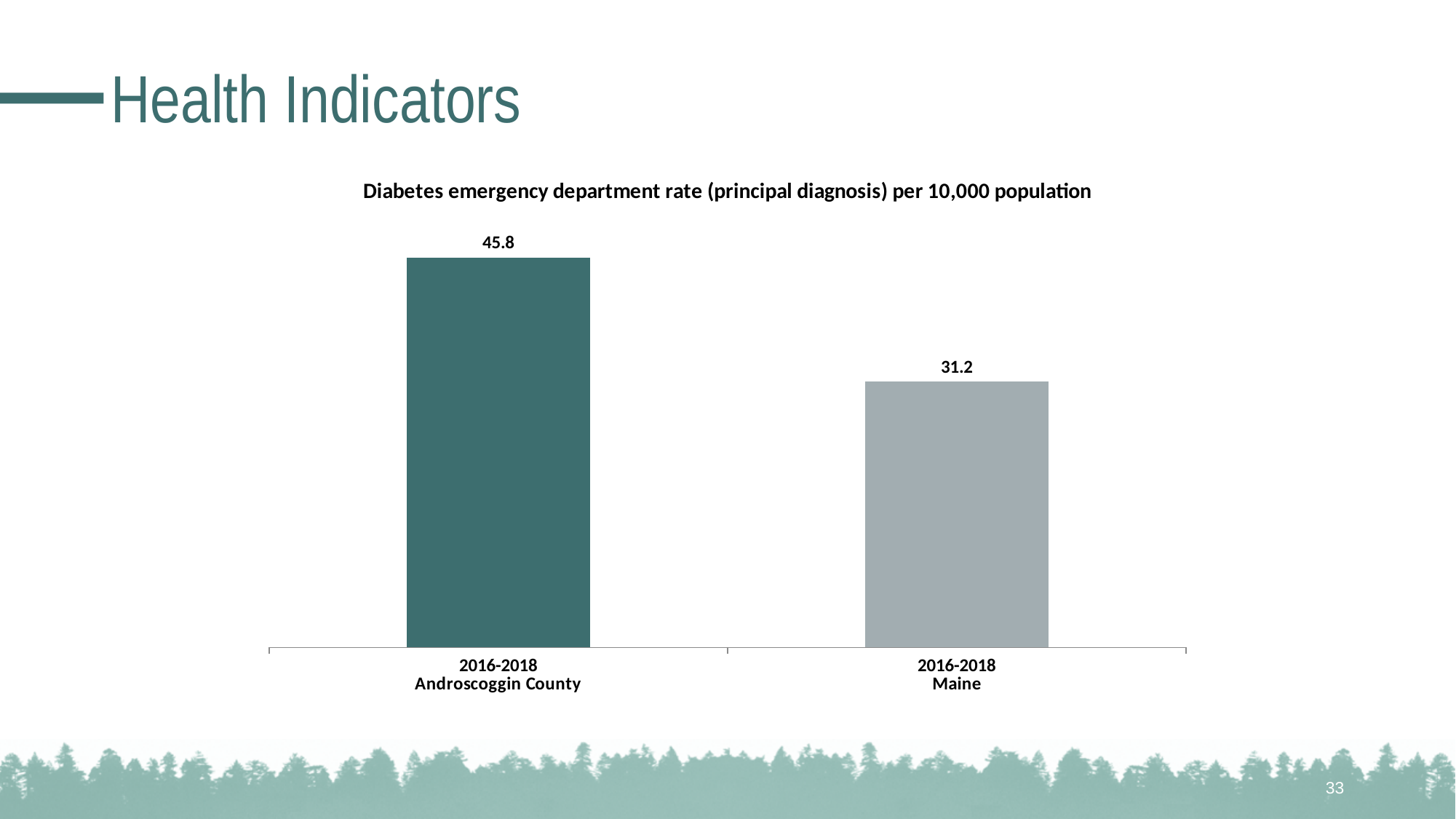
What time period do both bars in the chart cover? 2016-2018 How many bars are shown in the chart? 2 What is the difference between the Androscoggin County rate and the Maine rate? 14.6 What is the title of the chart? Diabetes emergency department rate (principal diagnosis) per 10,000 population What is the diabetes emergency department rate per 10,000 population for Androscoggin County in 2016-2018? 45.8 Which category has the higher diabetes emergency department rate? Androscoggin County What is the diabetes emergency department rate per 10,000 population for Maine in 2016-2018? 31.2 Which category has the lower diabetes emergency department rate? Maine Is the diabetes emergency department rate higher for Androscoggin County or for Maine? Androscoggin County What type of chart is shown on the slide? Bar chart